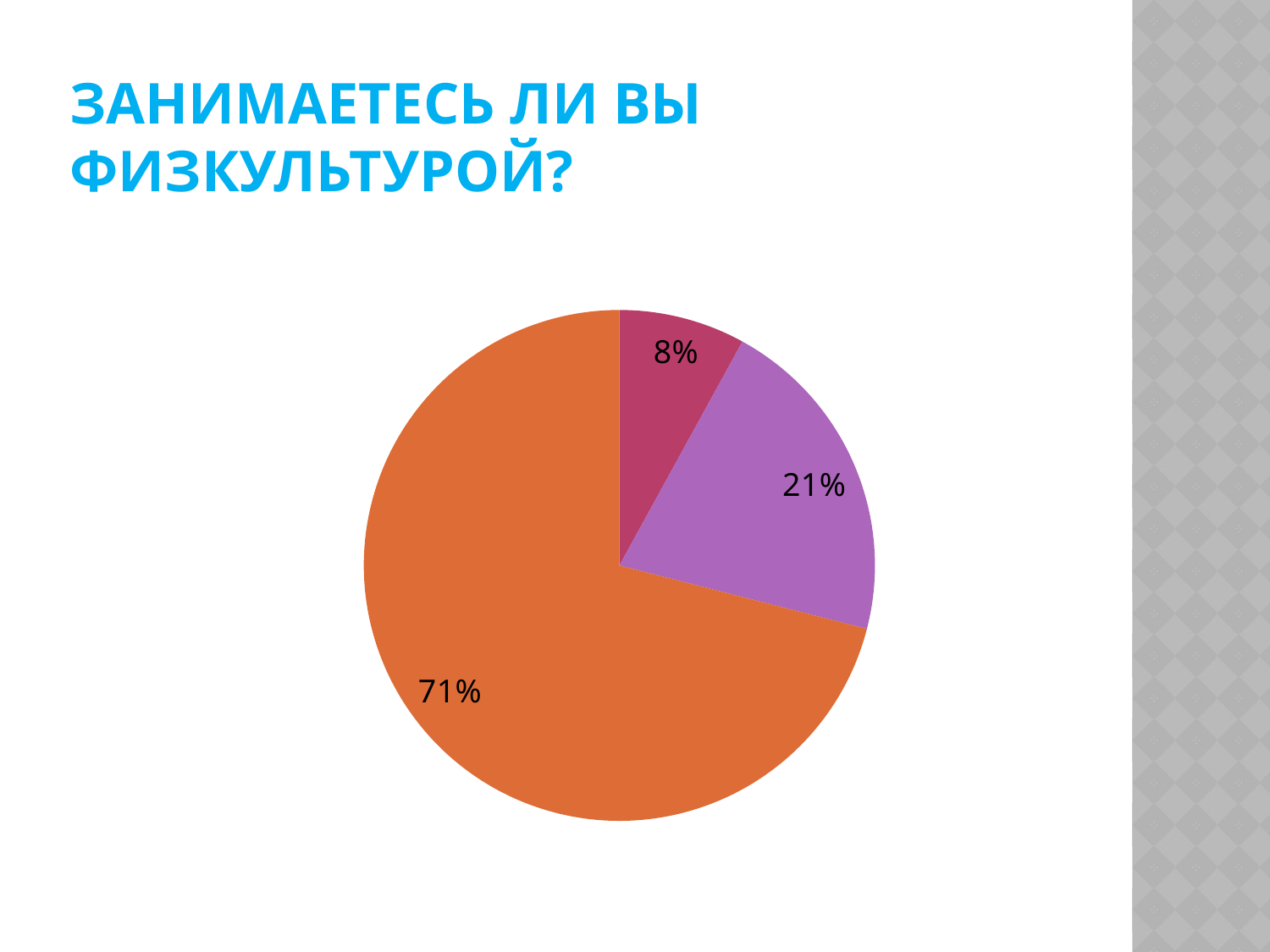
What percentage is shown on the orange slice of the pie chart? 71% What is the title of the slide containing the pie chart? ЗАНИМАЕТЕСЬ ЛИ ВЫ ФИЗКУЛЬТУРОЙ? What share of the pie does the orange slice represent? 71% Which slice of the pie chart is the largest? the orange slice (71%) What percentage is shown on the purple slice of the pie chart? 21% What percentage is shown on the dark red slice of the pie chart? 8% Which slice of the pie chart is the smallest? the dark red slice (8%) How many slices does the pie chart have? 3 What is the difference in percentage points between the orange slice and the purple slice? 50 What is the difference in percentage points between the purple slice and the dark red slice? 13 What kind of chart is shown on the slide? pie chart Which is larger, the purple slice or the dark red slice? the purple slice